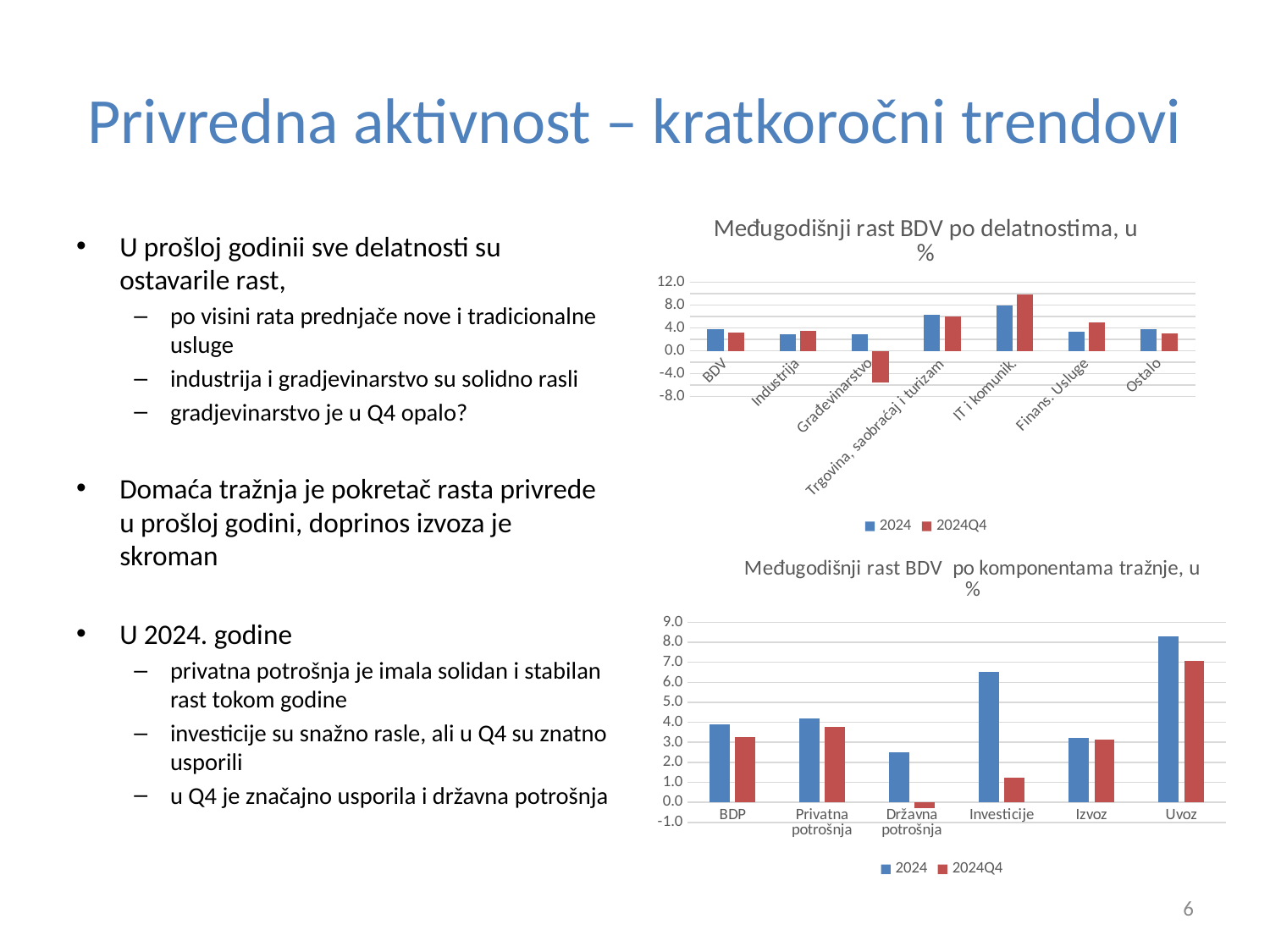
In the chart 'Međugodišnji rast BDV po komponentama tražnje, u %', is the 2024 value for Investicije greater or less than 6.0? greater In the chart 'Međugodišnji rast BDV po delatnostima, u %', is the 2024Q4 value for IT i komunik. greater or less than 8.0? greater In the chart 'Međugodišnji rast BDV po delatnostima, u %', is the 2024Q4 value for Građevinarstvo greater or less than 0.0? less How many series does the legend of the chart 'Međugodišnji rast BDV po delatnostima, u %' list? 2 In the chart 'Međugodišnji rast BDV po komponentama tražnje, u %', which is larger for Investicije: the 2024 value or the 2024Q4 value? 2024 In the chart 'Međugodišnji rast BDV po delatnostima, u %', which category has the lowest 2024Q4 value? Građevinarstvo In the chart 'Međugodišnji rast BDV po komponentama tražnje, u %', which category has the highest 2024 value? Uvoz How many categories are shown on the x axis of the chart 'Međugodišnji rast BDV po komponentama tražnje, u %'? 6 What kind of chart is 'Međugodišnji rast BDV po komponentama tražnje, u %'? bar chart How many categories are shown on the x axis of the chart 'Međugodišnji rast BDV po delatnostima, u %'? 7 In the chart 'Međugodišnji rast BDV po delatnostima, u %', which category has the highest 2024Q4 value? IT i komunik. In the chart 'Međugodišnji rast BDV po komponentama tražnje, u %', which category has the lowest 2024Q4 value? Državna potrošnja